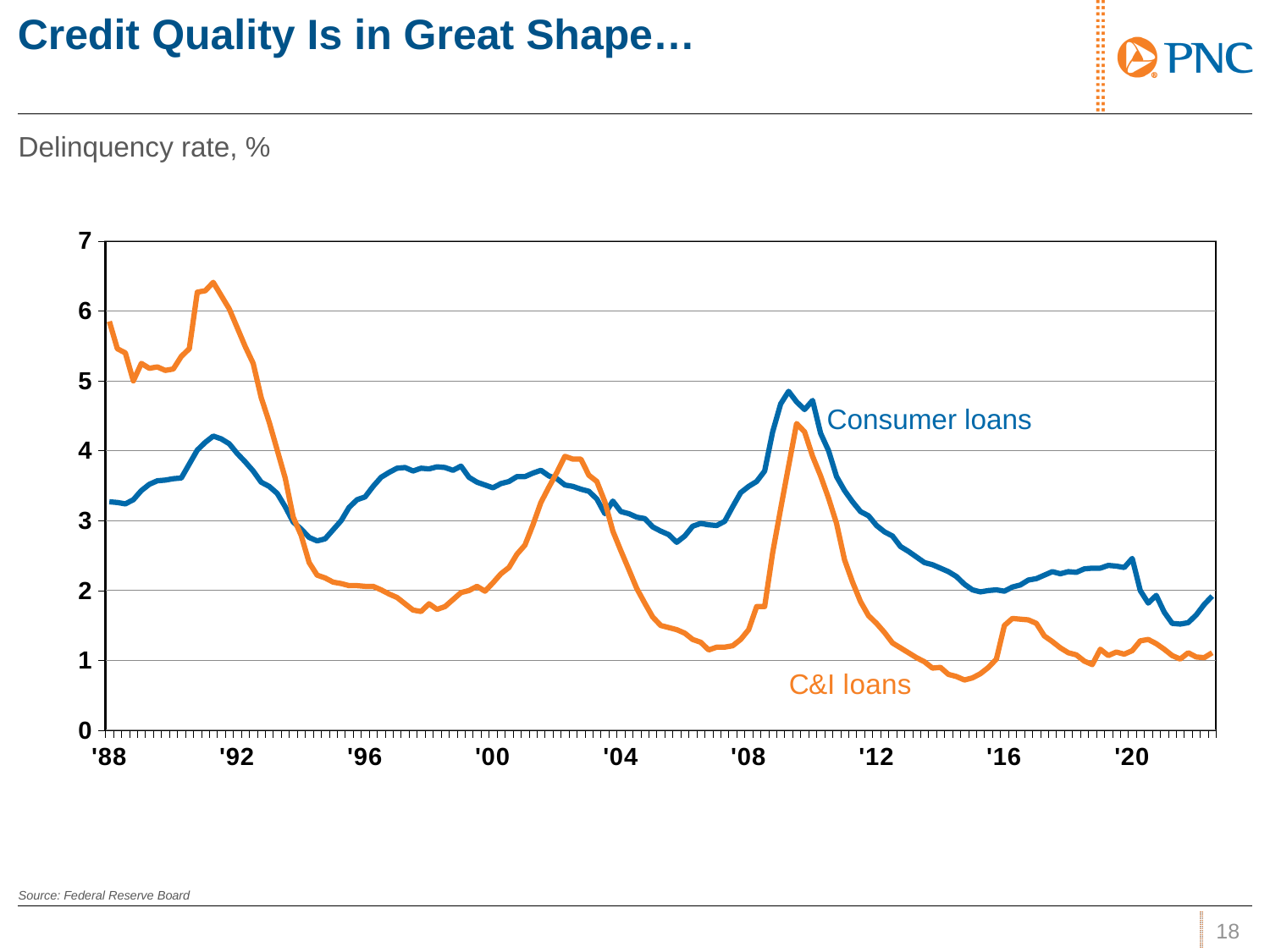
At '96, which series has the higher delinquency rate, Consumer loans or C&I loans? Consumer loans Which series reaches the lowest delinquency rate anywhere on the chart? C&I loans How many year labels are shown on the x axis? 9 Is the value for C&I loans around '15 greater or less than 1? less What type of chart is shown on the slide? line chart How many data series are plotted on the chart? 2 What unit is the delinquency rate measured in, according to the label above the chart? % Does the C&I loans delinquency rate rise or fall between '92 and '95? fall At '92, which series has the higher delinquency rate, Consumer loans or C&I loans? C&I loans Which series reaches the highest delinquency rate anywhere on the chart? C&I loans Is the peak value for C&I loans around '91–'92 greater or less than 6? greater Is the peak value for Consumer loans around '09 greater or less than 4? greater